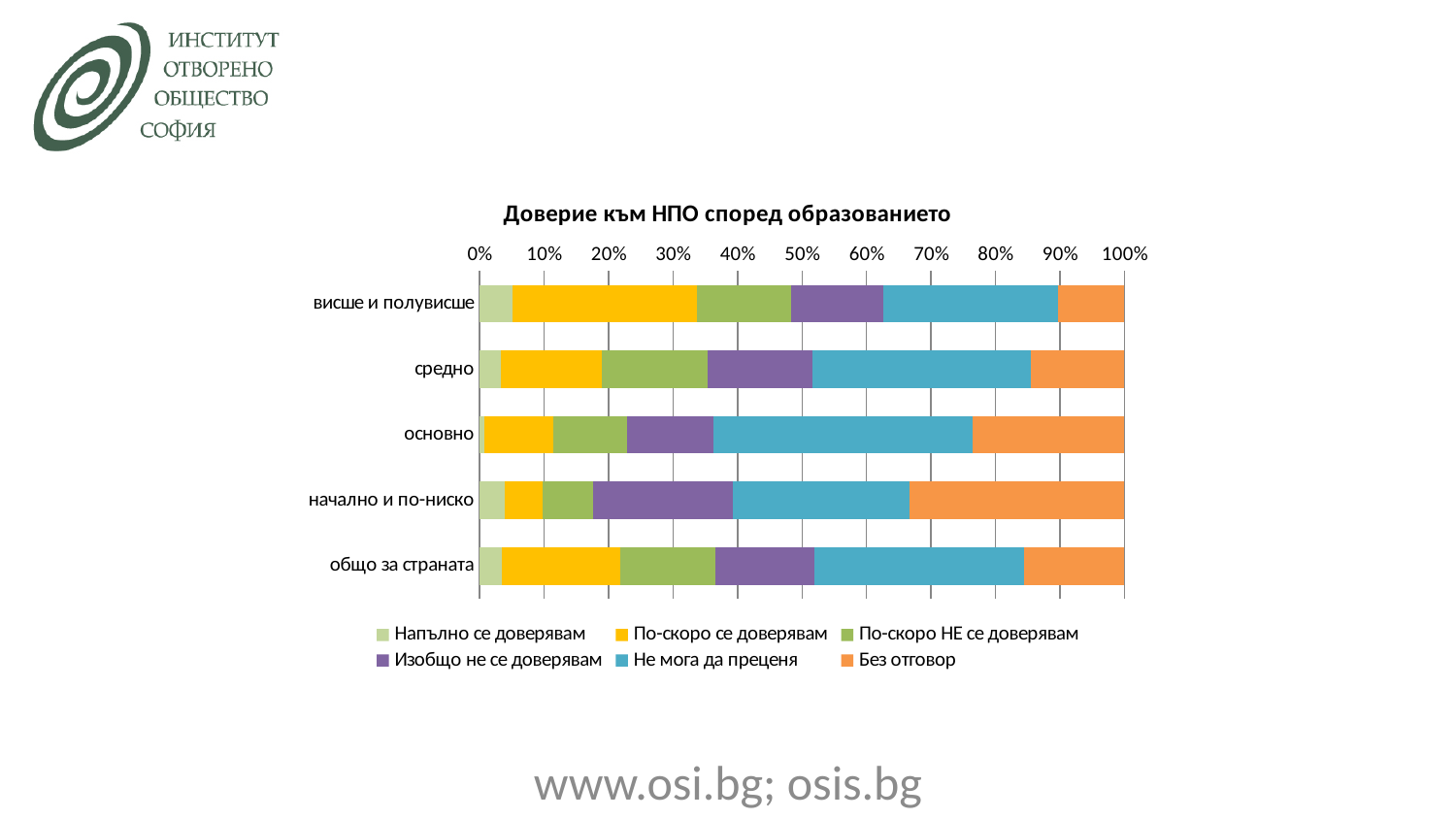
Which category has the largest "Без отговор" segment? начално и по-ниско Which has a larger "Без отговор" segment, висше и полувисше or основно? основно What kind of chart is shown on the slide? bar chart Is the "Не мога да преценя" share for основно greater or less than 30%? greater Which category has the largest "По-скоро се доверявам" segment? висше и полувисше Is the "По-скоро се доверявам" share for висше и полувисше greater or less than 20%? greater What is the title of the chart? Доверие към НПО според образованието Which category has the smallest "По-скоро се доверявам" segment? начално и по-ниско How many series does the legend list? 6 Is the "Без отговор" share for начално и по-ниско greater or less than 20%? greater Which category has the largest "Изобщо не се доверявам" segment? начално и по-ниско How many education categories are plotted on the chart? 5